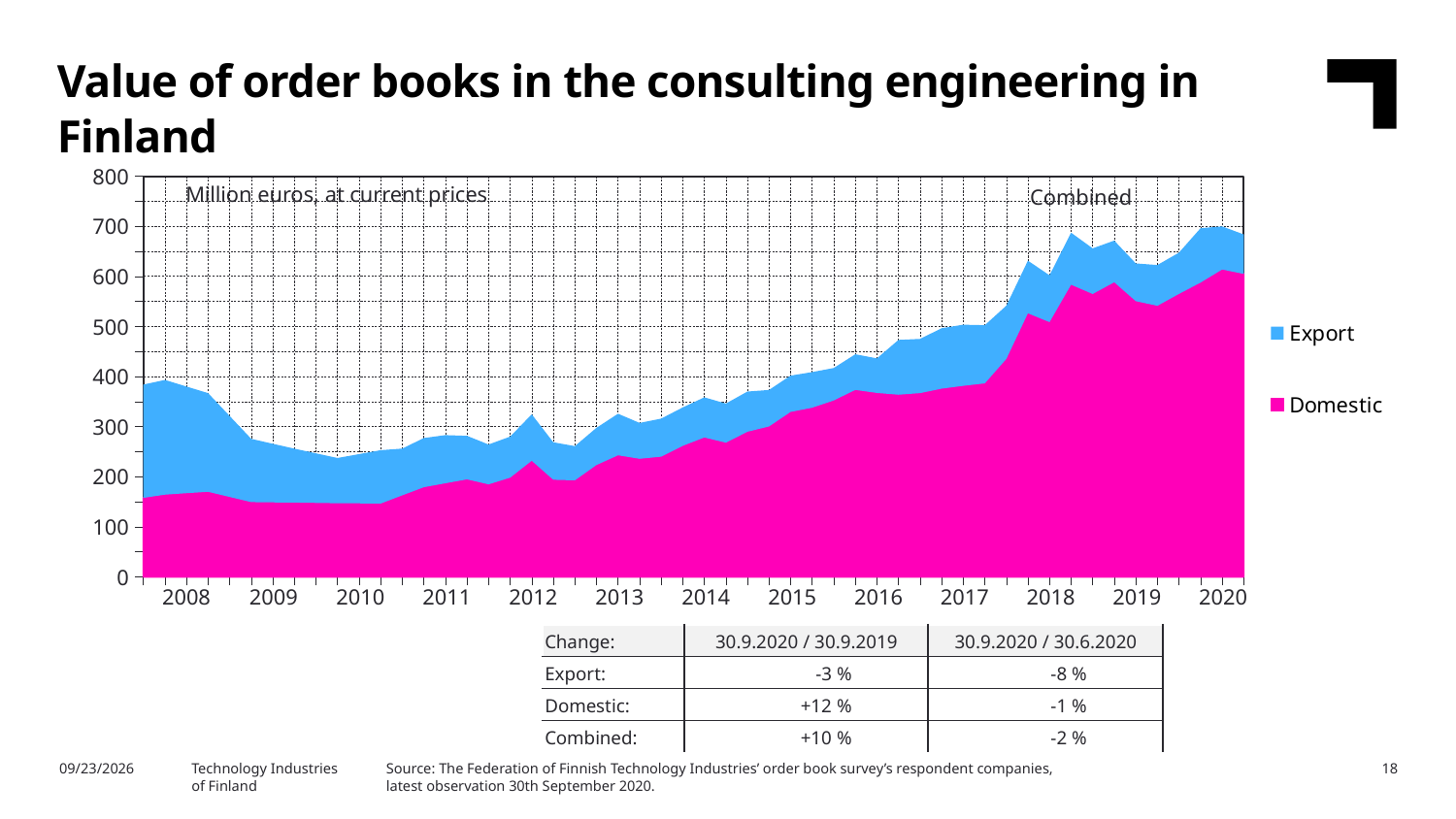
Does the Domestic series generally rise or fall from 2008 to 2020? Rise Is the Domestic value in 2020 greater or less than 500? greater What unit is stated inside the chart area? Million euros, at current prices In 2020, which series is larger, Export or Domestic? Domestic How many series does the chart legend list? 2 What are the two series named in the chart legend? Export and Domestic Is the Combined value in 2020 greater or less than 600? greater Is the Combined value in 2014 greater or less than 300? greater What kind of chart is shown on the slide? Area chart How many years are labelled on the x axis of the chart? 13